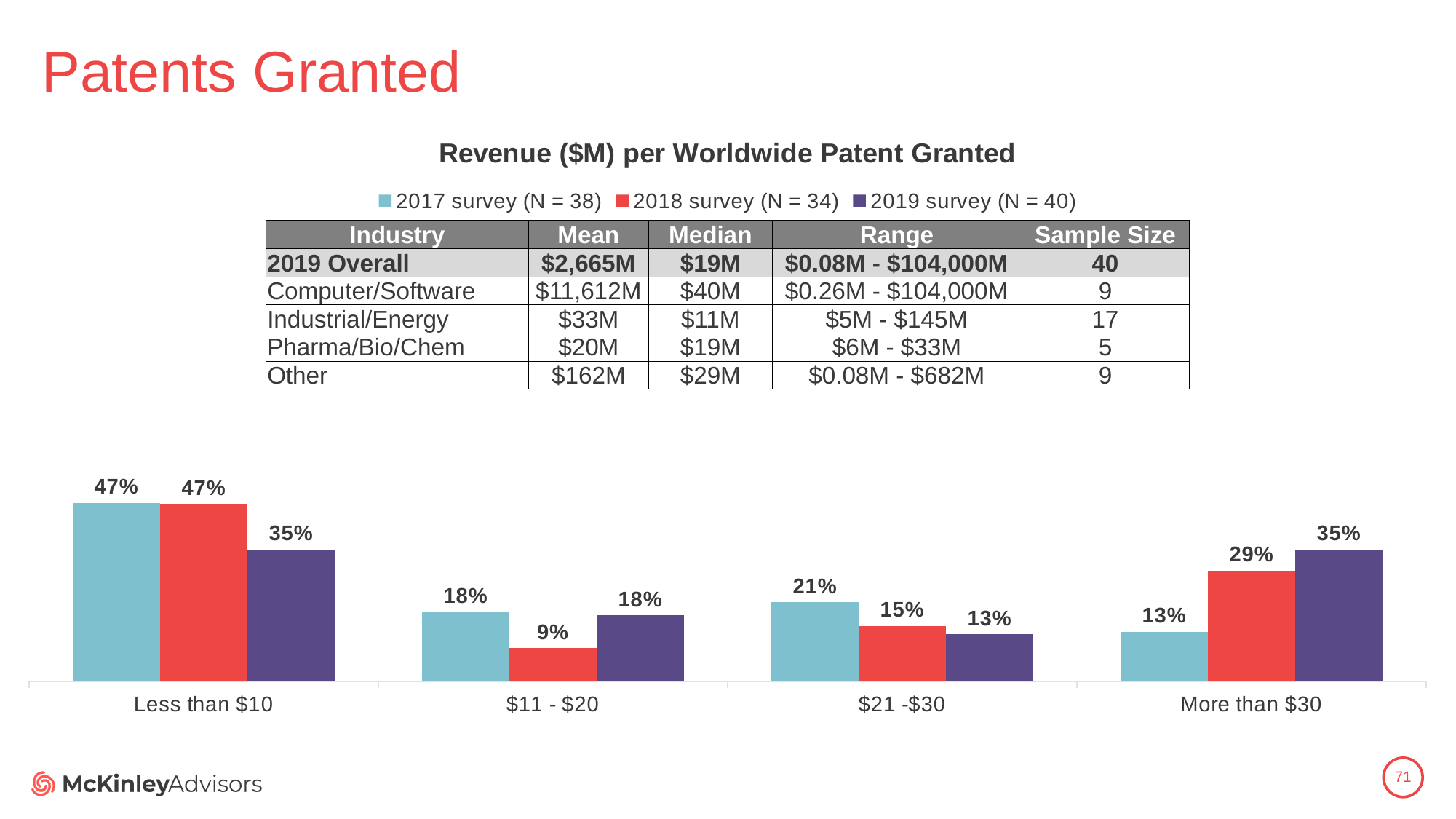
What kind of chart is shown on the slide? Bar chart What is the value for the 2017 survey in the 'More than $30' category? 13% What is the difference between the 2019 survey and 2017 survey values in the 'More than $30' category? 22% How many series does the legend list? 3 In the '$21 -$30' category, which is larger: the 2017 survey value or the 2019 survey value? 2017 survey What is the difference between the 2017 survey and 2019 survey values in the 'Less than $10' category? 12% How many categories are shown on the x axis of the bar chart? 4 What is the value for the 2019 survey in the 'Less than $10' category? 35% Which category has the highest value for the 2019 survey? Less than $10 and More than $30 (tied at 35%) Which category has the lowest value for the 2018 survey? $11 - $20 What is the title of the chart? Revenue ($M) per Worldwide Patent Granted What is the value for the 2018 survey in the '$11 - $20' category? 9%